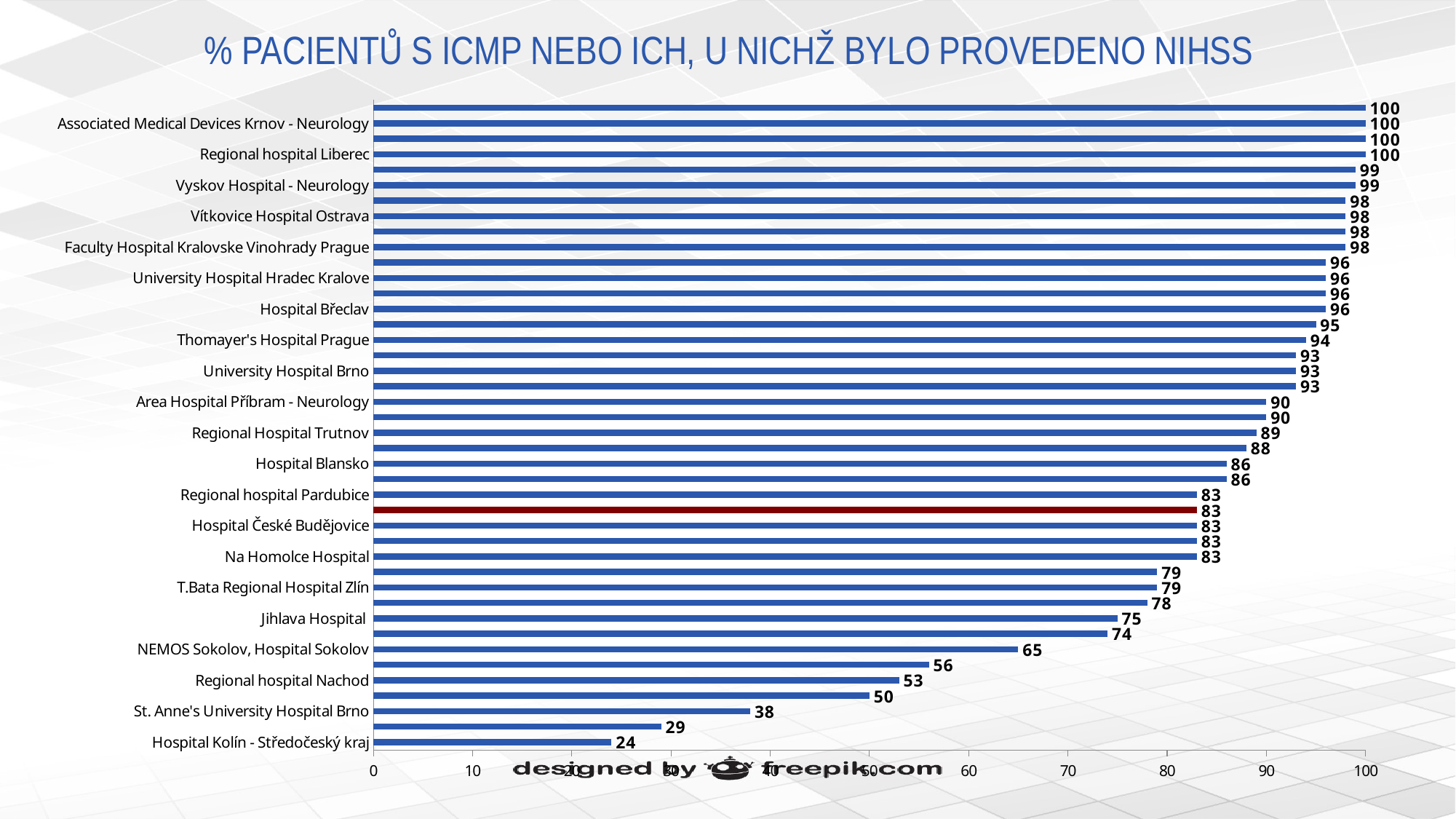
What is the value for NEMOS Sokolov, Hospital Sokolov? 65 Which has a larger value, Thomayer's Hospital Prague or Hospital Blansko? Thomayer's Hospital Prague What type of chart is shown on the slide? bar chart What is the title of the chart? % PACIENTŮ S ICMP NEBO ICH, U NICHŽ BYLO PROVEDENO NIHSS What is the value for St. Anne's University Hospital Brno? 38 What is the difference between the values for NEMOS Sokolov, Hospital Sokolov and St. Anne's University Hospital Brno? 27 What is the value for Hospital Kolín - Středočeský kraj? 24 Do the values rise or fall going from the top bar to the bottom bar? fall What is the value for Regional hospital Nachod? 53 Which labeled hospital has the lowest value? Hospital Kolín - Středočeský kraj What is the value for Regional hospital Liberec? 100 What is the value for Jihlava Hospital? 75